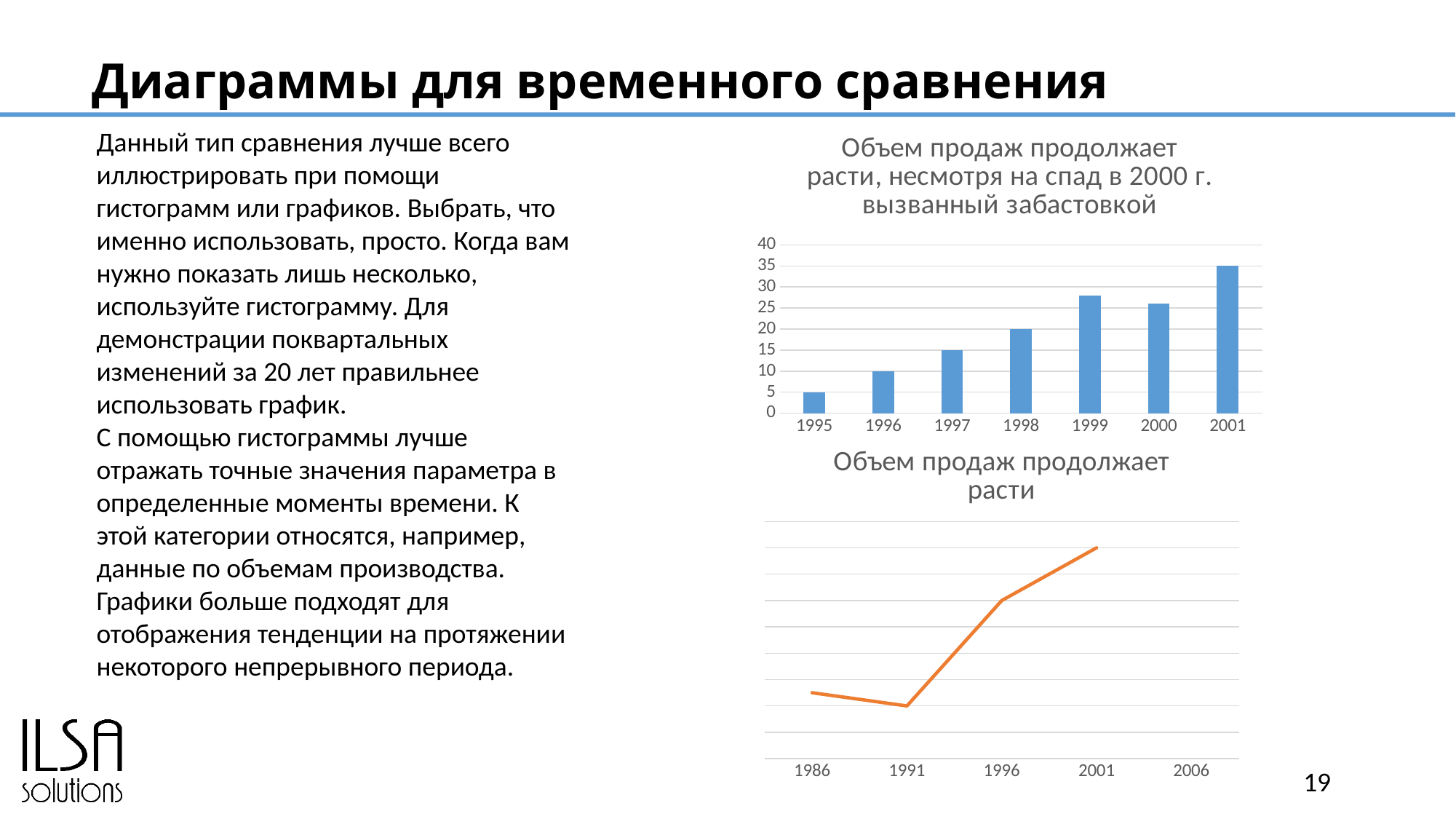
In the top bar chart, is the value for 2000 greater or less than 30? less What kind of chart is the bottom chart titled "Объем продаж продолжает расти"? line chart What kind of chart is the top chart titled "Объем продаж продолжает расти, несмотря на спад в 2000 г. вызванный забастовкой"? bar chart In the top bar chart, what is the value for 1995? 5 In the top bar chart, what is the value for 1998? 20 In the top bar chart, which year has the lowest value? 1995 In the top bar chart, what is the value for 2001? 35 In the bottom line chart, at which year is the line at its lowest point? 1991 In the top bar chart, which year has the highest value? 2001 In the top bar chart, what is the difference between the values for 2001 and 1995? 30 How many years are shown on the x axis of the top bar chart? 7 In the top bar chart, which year has the larger value, 1999 or 2000? 1999